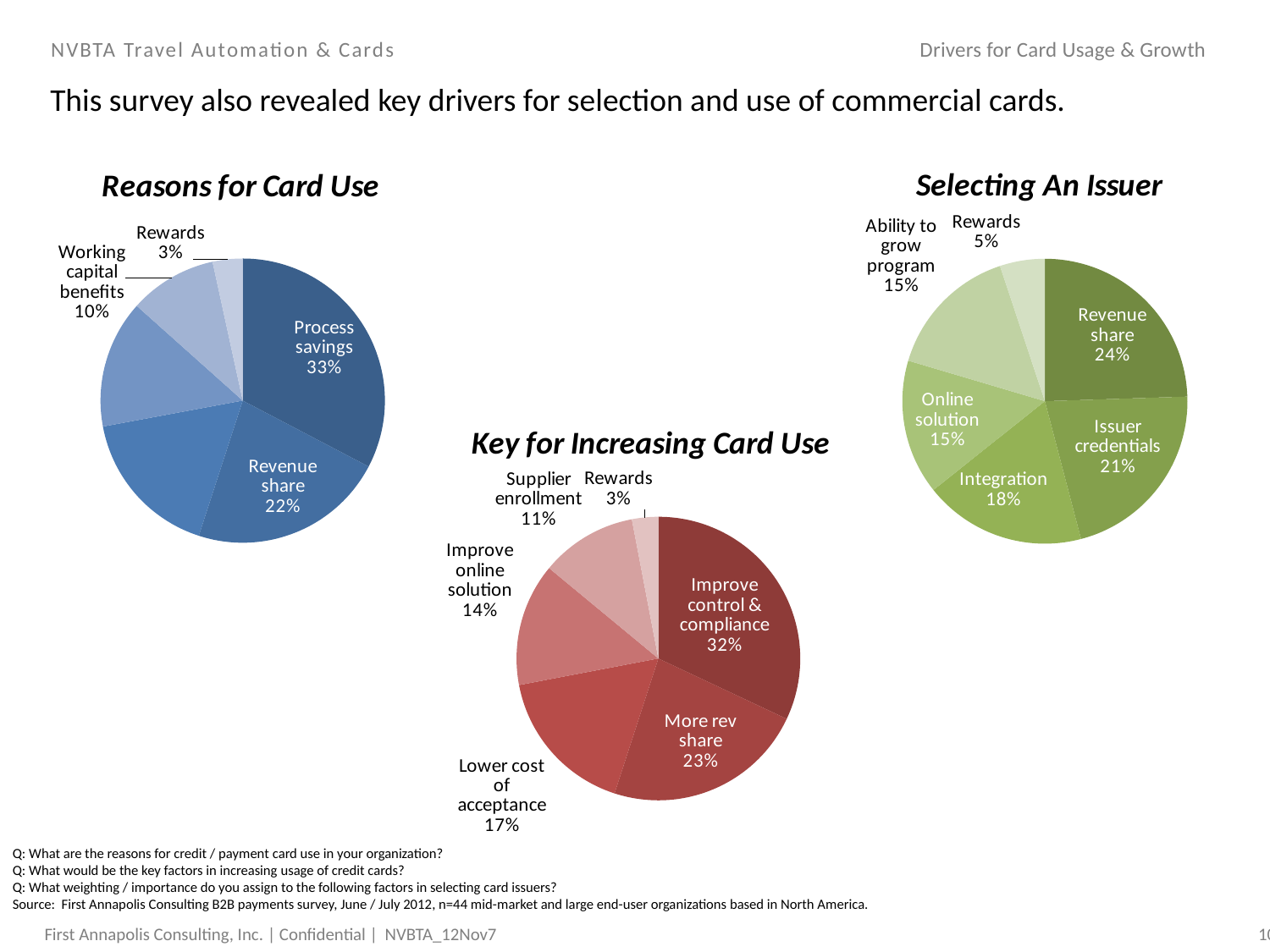
In the 'Reasons for Card Use' chart, what share is Process savings? 33% In the 'Selecting An Issuer' chart, what is the difference between Revenue share and Rewards? 19% In the 'Selecting An Issuer' chart, which is larger, Integration or Online solution? Integration What type of chart is 'Selecting An Issuer'? Pie chart In the 'Key for Increasing Card Use' chart, what share is Improve control & compliance? 32% In the 'Key for Increasing Card Use' chart, what share is Lower cost of acceptance? 17% In the 'Reasons for Card Use' chart, which labeled slice is the smallest? Rewards In the 'Reasons for Card Use' chart, what share is Working capital benefits? 10% In the 'Selecting An Issuer' chart, what share is Issuer credentials? 21% In the 'Key for Increasing Card Use' chart, how many slices does the pie have? 6 In the 'Key for Increasing Card Use' chart, what is the difference between More rev share and Supplier enrollment? 12% In the 'Selecting An Issuer' chart, which slice is the largest? Revenue share